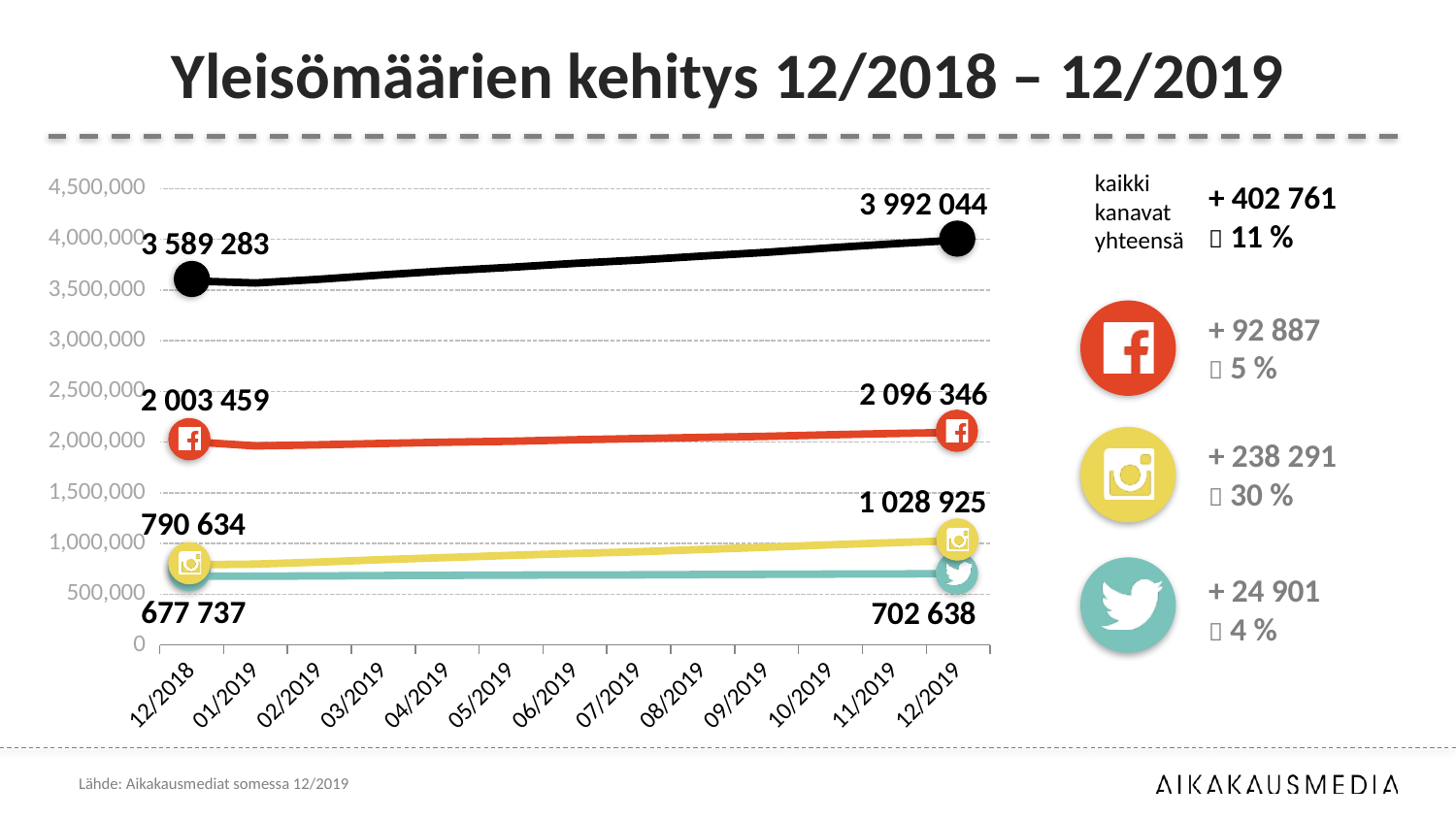
How many months are labelled on the x axis? 13 What is the value of the teal Twitter line at 12/2019? 702 638 What is the value of the yellow Instagram line at 12/2018? 790 634 What is the value of the black (total) line at 12/2018? 3 589 283 What is the value of the red Facebook line at 12/2019? 2 096 346 Does the yellow Instagram line rise or fall from 12/2018 to 12/2019? rise By how much did the black (total) line increase from 12/2018 to 12/2019? 402 761 What is the value of the black (total) line at 12/2019? 3 992 044 Which line has the lowest value at 12/2019? the teal Twitter line At 12/2019, which is larger: the yellow Instagram line or the teal Twitter line? the yellow Instagram line By how much did the yellow Instagram line increase from 12/2018 to 12/2019? 238 291 What type of chart is shown on the slide? line chart